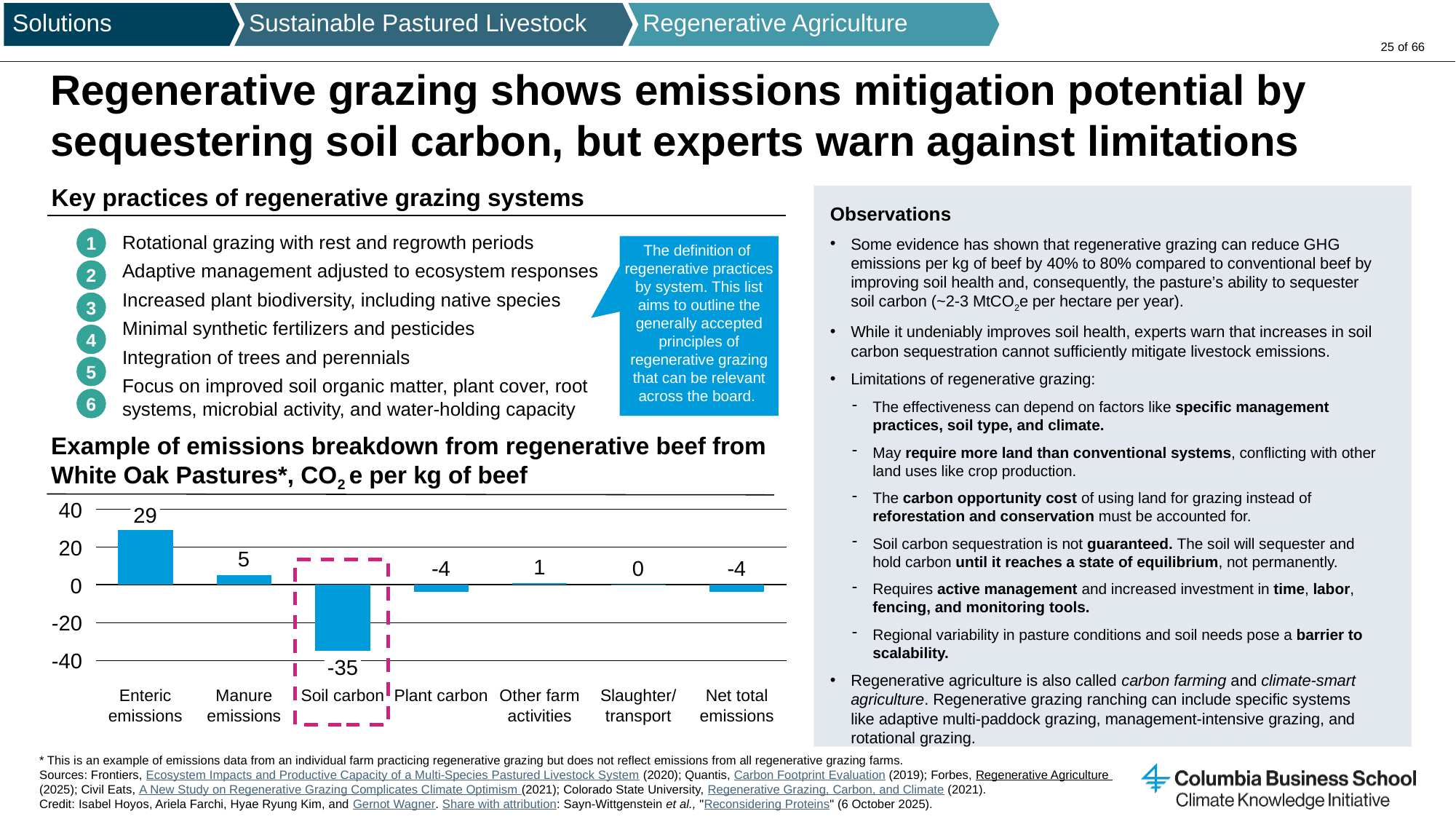
How many categories are shown in the emissions breakdown chart? 7 What is the difference between the values for Enteric emissions and Manure emissions in the emissions breakdown chart? 24 What is the value for Net total emissions in the emissions breakdown chart? -4 Which is larger in the emissions breakdown chart, the value for Manure emissions or the value for Other farm activities? Manure emissions What type of chart is used for the emissions breakdown from regenerative beef? Bar chart Which category has the highest value in the emissions breakdown chart? Enteric emissions Is the value for Enteric emissions in the emissions breakdown chart greater or less than 20? greater Which category has the lowest value in the emissions breakdown chart? Soil carbon What is the value for Enteric emissions in the emissions breakdown chart? 29 What is the value for Manure emissions in the emissions breakdown chart? 5 What is the value for Slaughter/transport in the emissions breakdown chart? 0 What is the value for Soil carbon in the emissions breakdown chart? -35